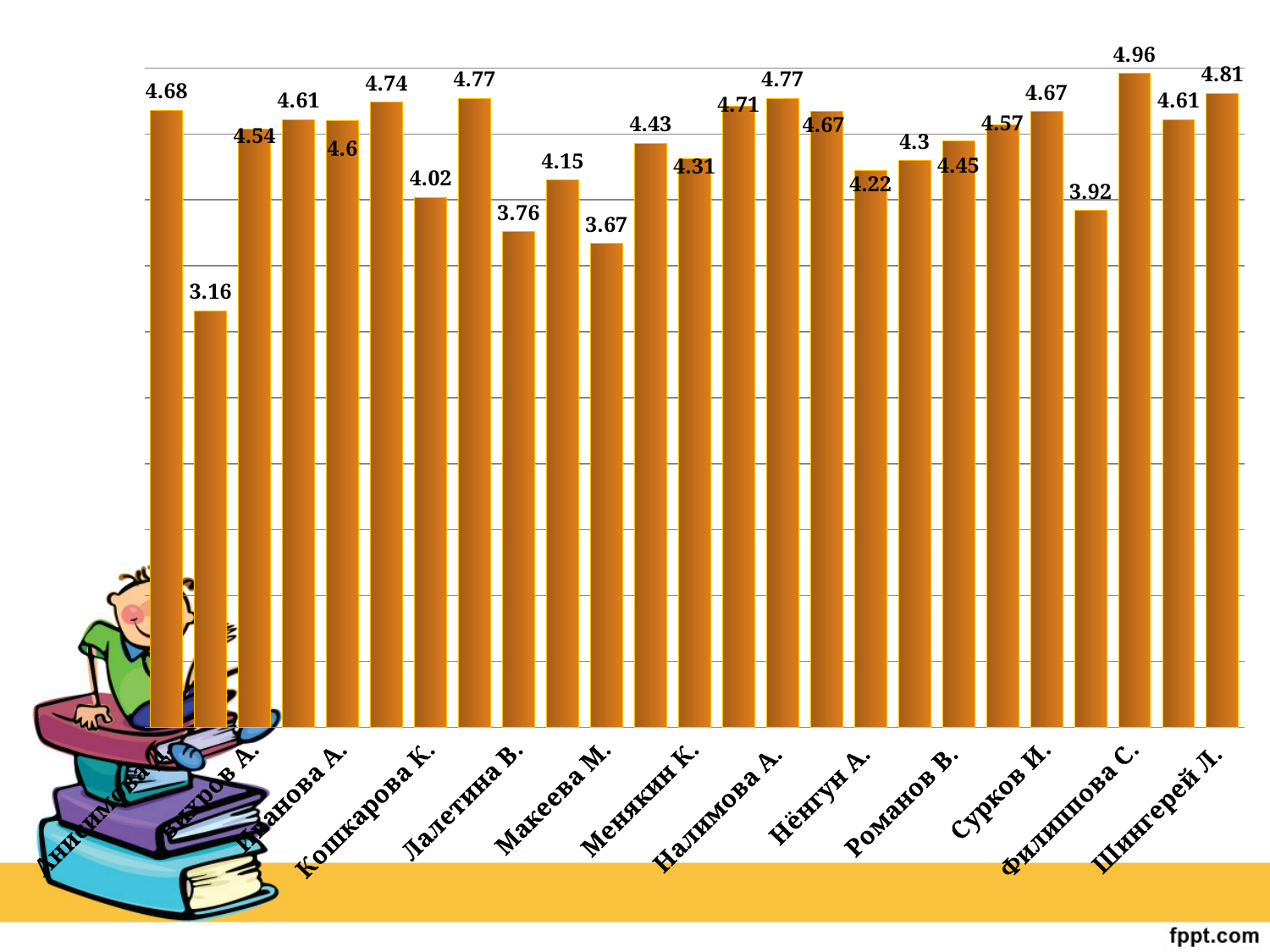
What is the value of the bar for Макеева М.? 3.67 What is the lowest value shown on any bar in the chart? 3.16 What is the value of the bar for Сурков И.? 4.67 What is the difference between the values for Филиппова С. and Шингерей Л.? 0.15 Which labelled category has the highest bar in the chart? Филиппова С. What is the value of the bar for Шингерей Л.? 4.81 Which has a larger value, Налимова А. or Кошкарова К.? Налимова А. What is the value of the bar for Филиппова С.? 4.96 What is the value of the bar for Кошкарова К.? 4.02 What is the value of the bar for Налимова А.? 4.77 What type of chart is shown on the slide? bar chart How many bars are plotted in the chart? 25